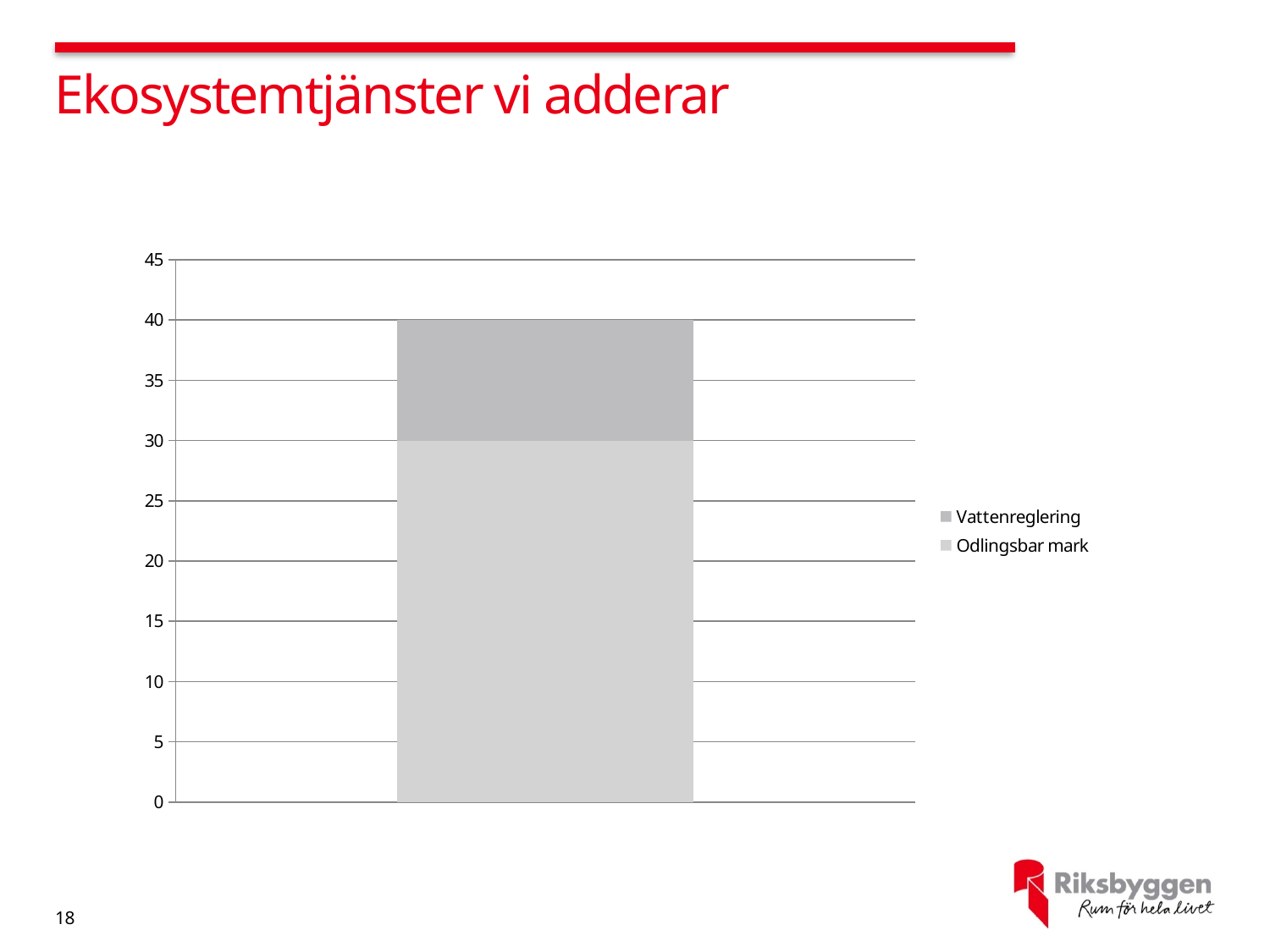
Which series has the larger segment in the bar, Vattenreglering or Odlingsbar mark? Odlingsbar mark What is the value of the Odlingsbar mark segment of the bar? 30 Is the total of the stacked bar greater or less than 35? greater Which series contributes the smallest segment to the bar? Vattenreglering How many series does the legend list? 2 How many bars are plotted in the chart? 1 Which legend entry is listed first? Vattenreglering Is the value for Vattenreglering greater or less than 15? less What is the total height of the stacked bar? 40 What is the highest value shown on the vertical axis? 45 What kind of chart is shown on the slide? Stacked bar chart